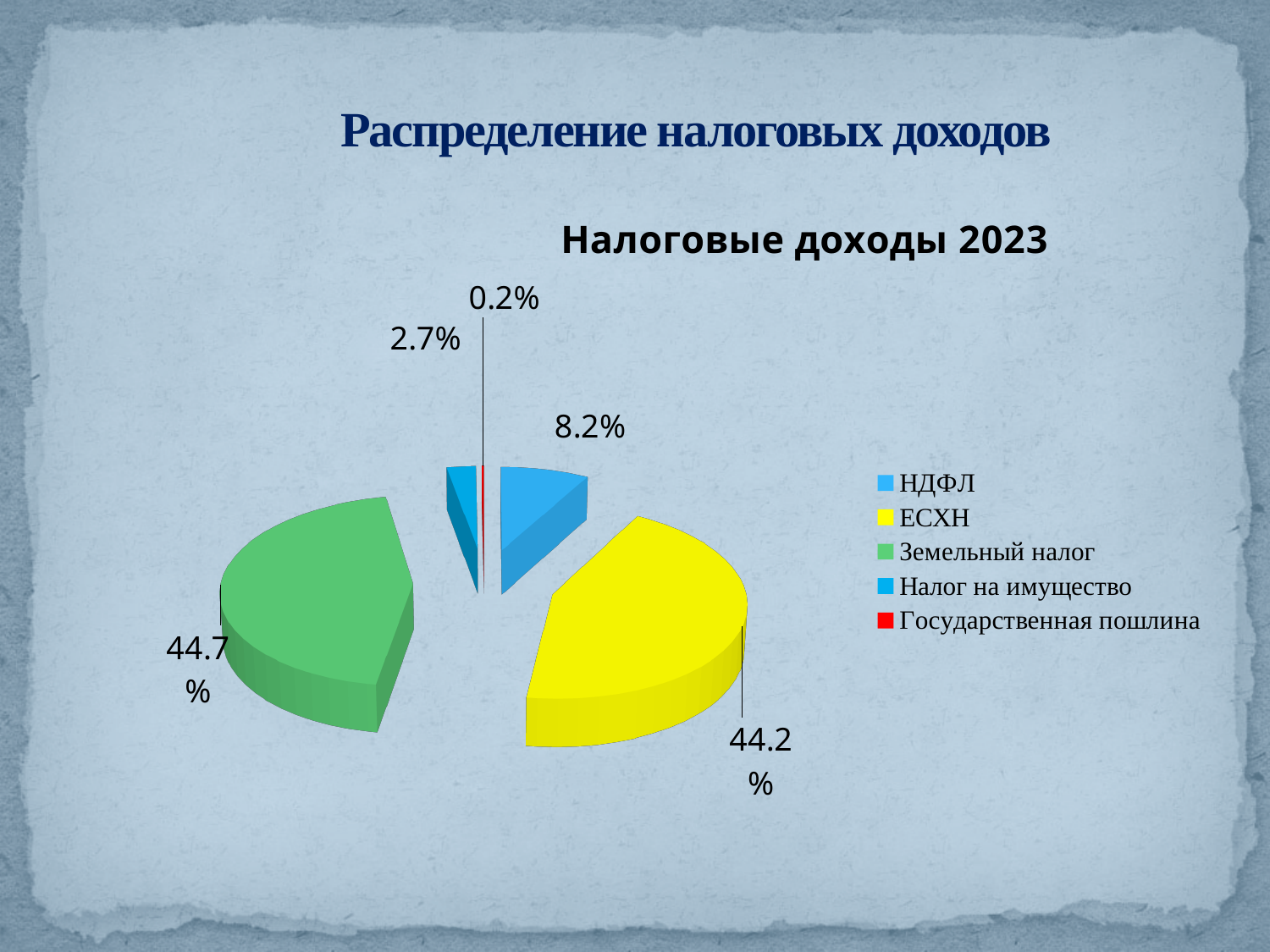
What type of chart is shown on the slide? pie chart What share of tax revenue does Земельный налог account for? 44.7% What is the title of the chart? Налоговые доходы 2023 Which colour represents ЕСХН in the chart? yellow What is the difference between the shares of Земельный налог and ЕСХН? 0.5% Which category has the largest share of tax revenue? Земельный налог What share of tax revenue does Налог на имущество account for? 2.7% Which category has the smallest share of tax revenue? Государственная пошлина What share of tax revenue does ЕСХН account for? 44.2% How many categories does the legend list? 5 What share of tax revenue does НДФЛ account for? 8.2% What share of tax revenue does Государственная пошлина account for? 0.2%